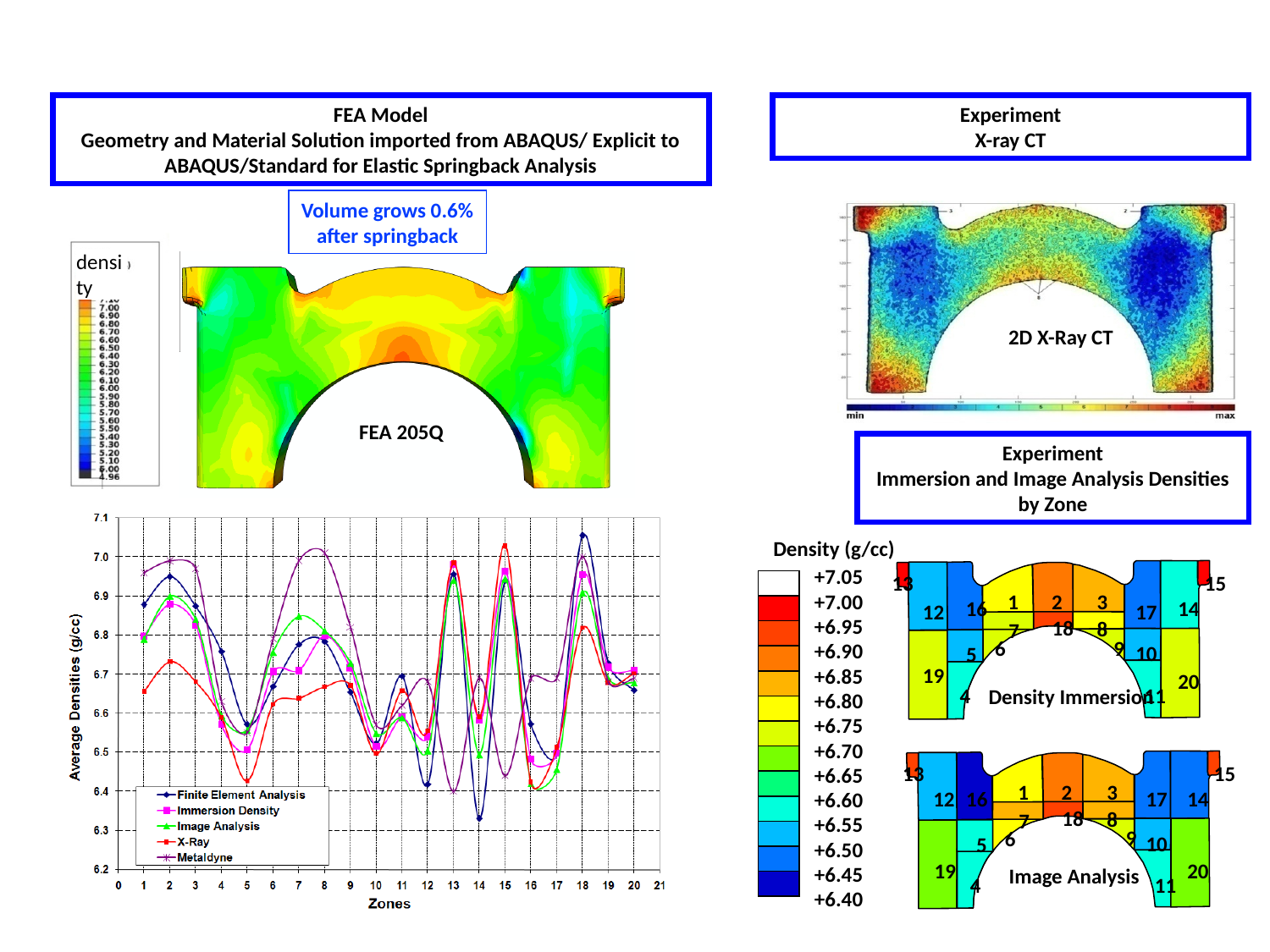
In the bottom-left line chart, which series has the lowest value at zone 14? Finite Element Analysis In the bottom-left line chart, which series has the highest value at zone 18? Finite Element Analysis What is the title of the y axis of the bottom-left line chart? Average Densities (g/cc) In the bottom-left line chart, is the X-Ray value at zone 15 greater or less than 6.9? greater What kind of chart is shown at the bottom left of the slide? line chart In the bottom-left line chart, is the Finite Element Analysis value at zone 14 greater or less than 6.4? less In the bottom-left line chart, how many zones are plotted along the x axis? 20 How many series does the legend of the bottom-left line chart list? 5 In the bottom-left line chart, is the Finite Element Analysis value at zone 18 greater or less than 7.0? greater What is the title of the x axis of the bottom-left line chart? Zones In the bottom-left line chart, at zone 2, which is larger: the Finite Element Analysis value or the X-Ray value? Finite Element Analysis